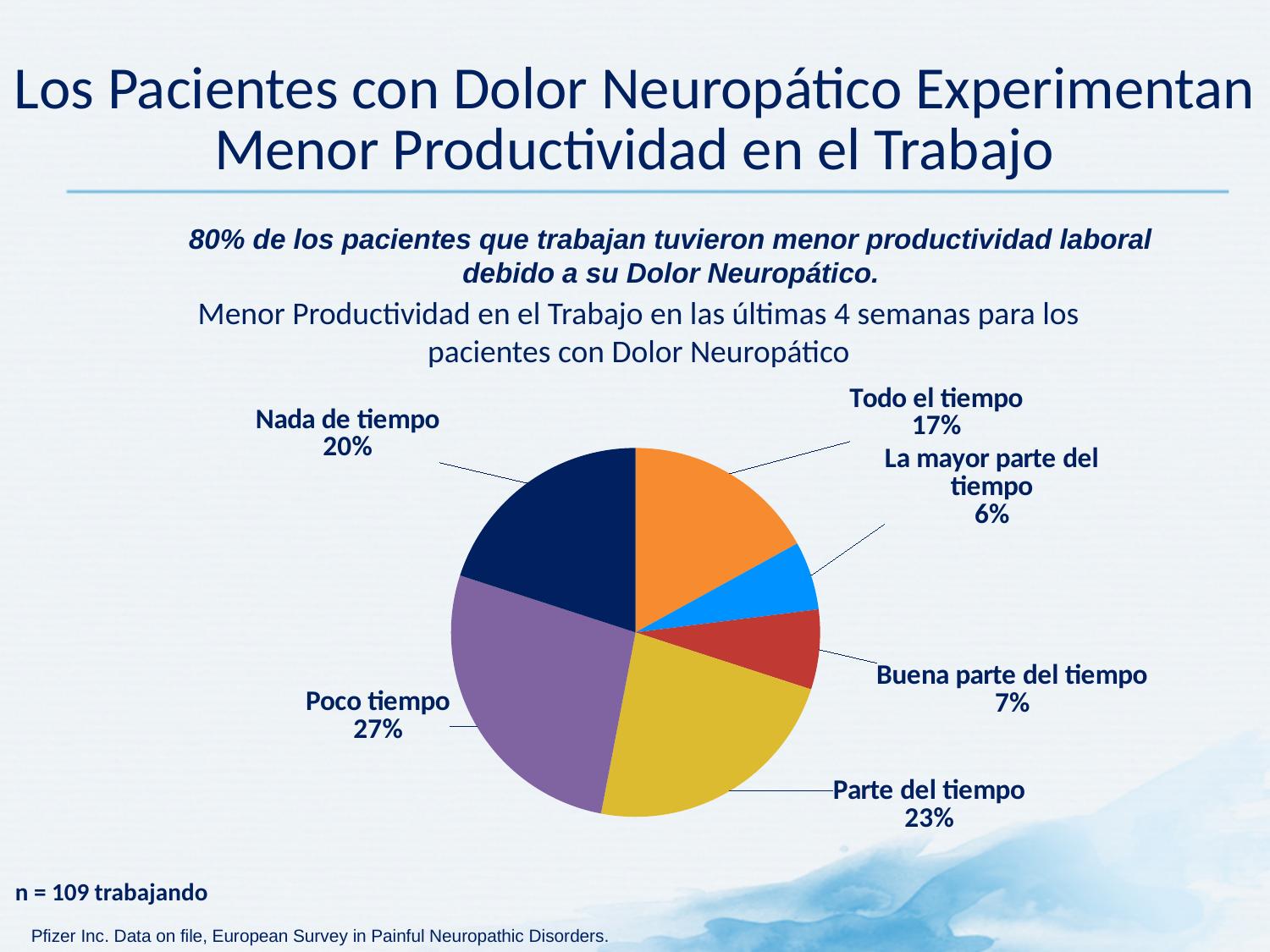
Which category has the smallest share of the pie? La mayor parte del tiempo What percentage of patients reported 'Poco tiempo' of reduced work productivity? 27% Which category has the largest share of the pie? Poco tiempo How many categories are shown in the pie chart? 6 What is the value for 'Nada de tiempo'? 20% What is the sample size noted below the chart? n = 109 trabajando What is the difference between 'Parte del tiempo' and 'Buena parte del tiempo'? 16% What is the value for 'Todo el tiempo'? 17% What kind of chart is shown on the slide? pie chart What is the value for 'La mayor parte del tiempo'? 6% Which is larger, 'Nada de tiempo' or 'Todo el tiempo'? Nada de tiempo What is the combined share of 'Todo el tiempo' and 'La mayor parte del tiempo'? 23%